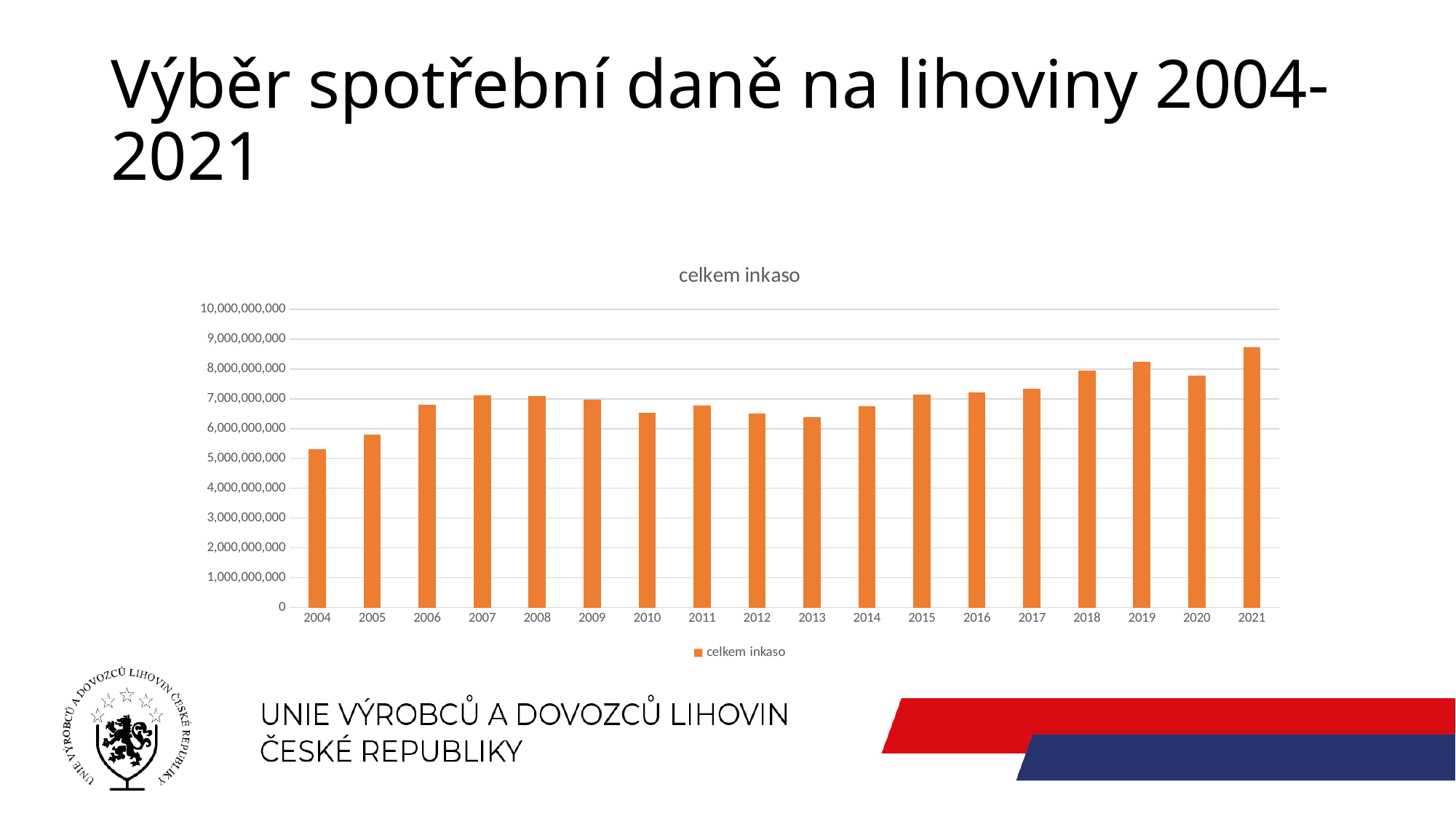
Is the value for 2005 greater or less than 6,000,000,000? less What type of chart is shown on the slide? bar chart What is the title of the chart? celkem inkaso Is the value for 2021 greater or less than 9,000,000,000? less Which year has the lowest value in the chart? 2004 Overall, do the values rise or fall from 2004 to 2021? rise Which year has the highest value in the chart? 2021 How many series does the legend list? 1 Is the value for 2004 greater or less than 5,000,000,000? greater How many years are shown on the x axis of the chart? 18 Which is larger, the value for 2019 or the value for 2020? 2019